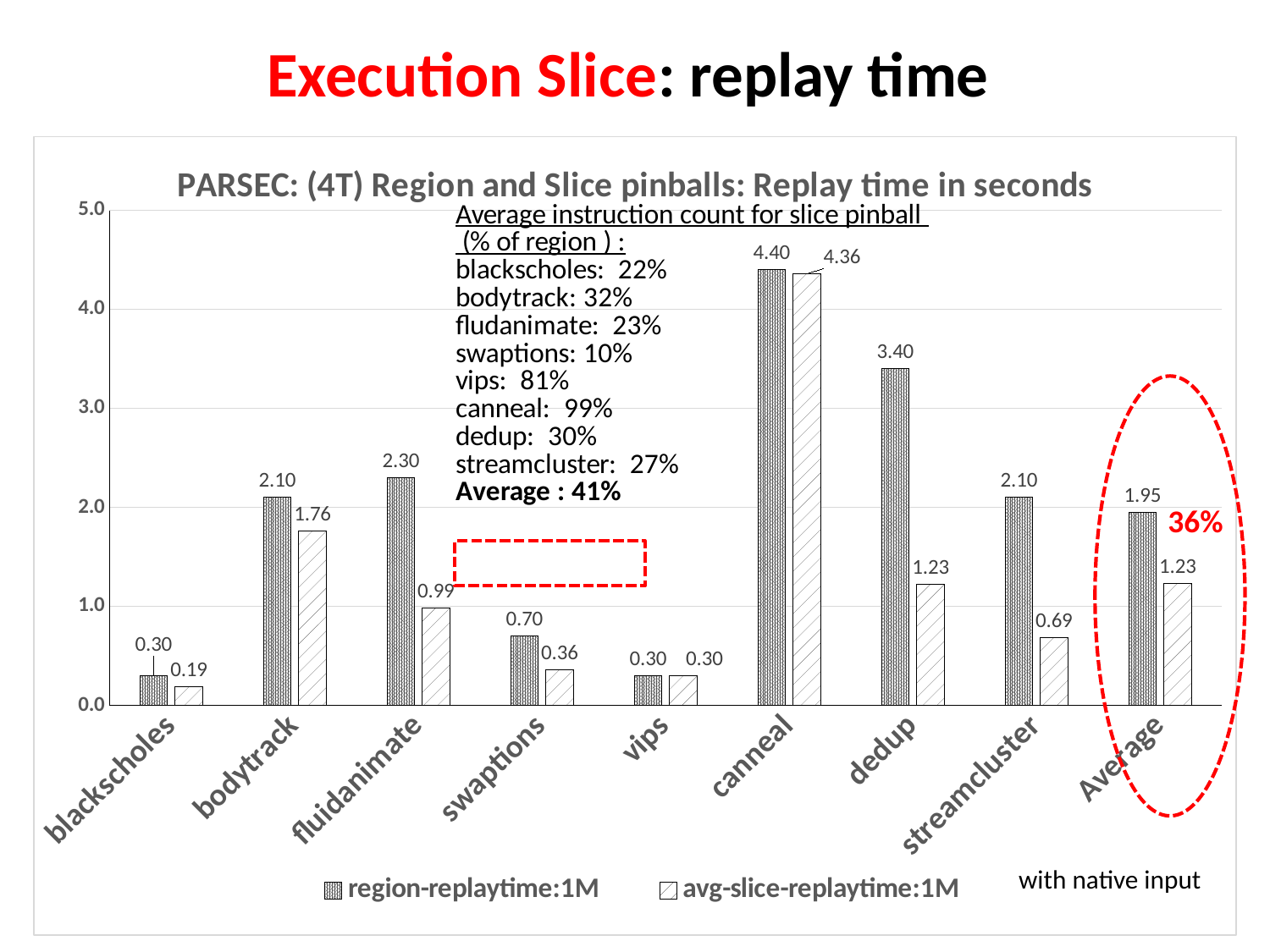
What is the title of the chart? PARSEC: (4T) Region and Slice pinballs: Replay time in seconds How many series does the legend list? 2 Which is larger for fluidanimate: region-replaytime:1M or avg-slice-replaytime:1M? region-replaytime:1M What is the difference between the region-replaytime:1M and avg-slice-replaytime:1M values for dedup? 2.17 Which category has the lowest avg-slice-replaytime:1M value? blackscholes What kind of chart is shown on the slide? bar chart Which category has the highest region-replaytime:1M value? canneal What is the avg-slice-replaytime:1M value for Average? 1.23 What is the region-replaytime:1M value for canneal? 4.40 What is the region-replaytime:1M value for swaptions? 0.70 How many categories are shown on the x axis? 9 What is the avg-slice-replaytime:1M value for bodytrack? 1.76